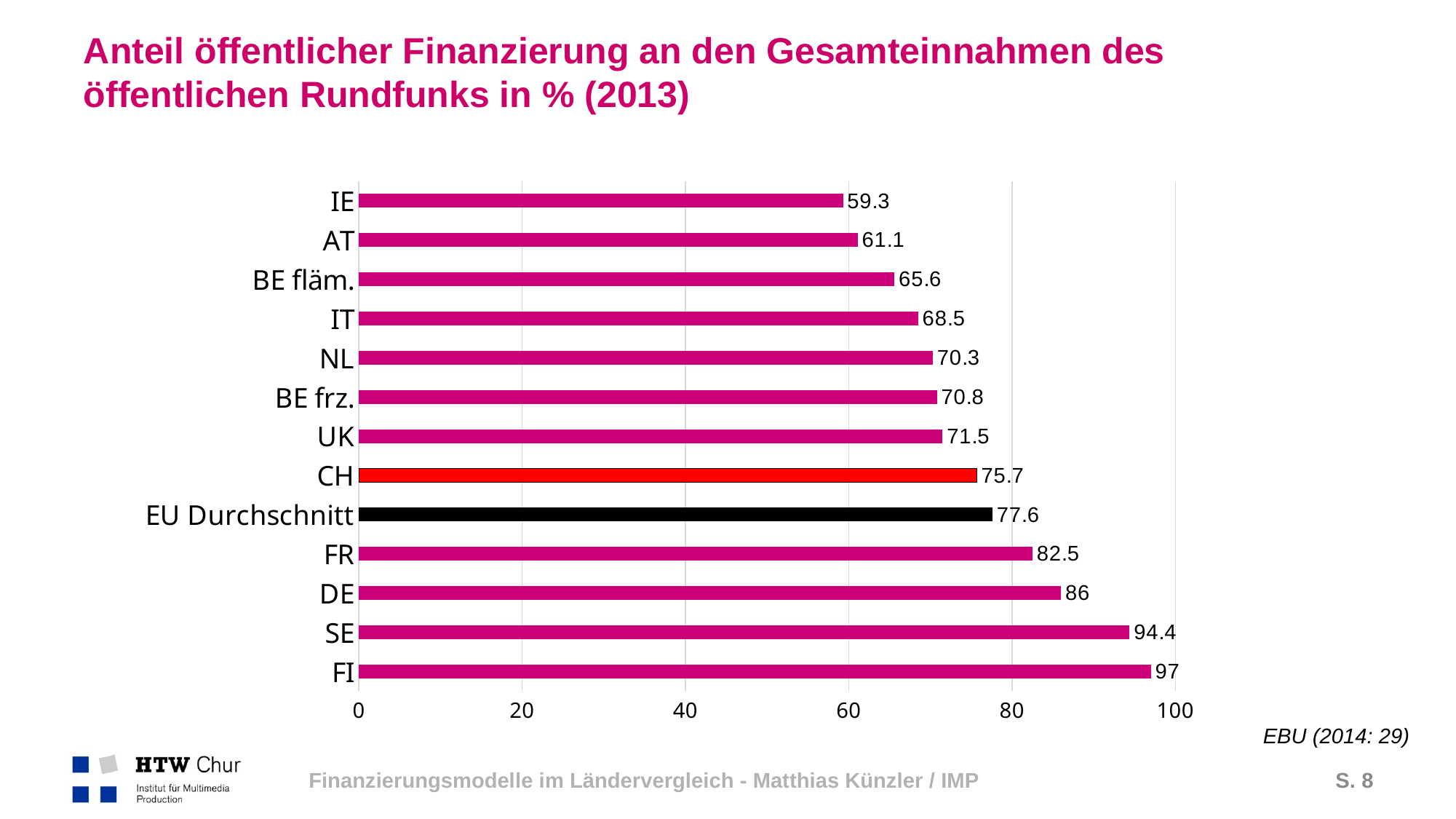
Which is larger, the value for FR or the value for UK? FR What is the value for DE? 86 Which category has the highest value? FI Which category has the lowest value? IE What is the value for EU Durchschnitt? 77.6 What kind of chart is shown on the slide? bar chart What is the difference between the values for EU Durchschnitt and CH? 1.9 What is the value for CH? 75.7 Which bar is coloured red? CH Is the value for SE greater or less than 80? greater How many categories are shown in the chart? 13 What is the difference between the values for FI and IE? 37.7